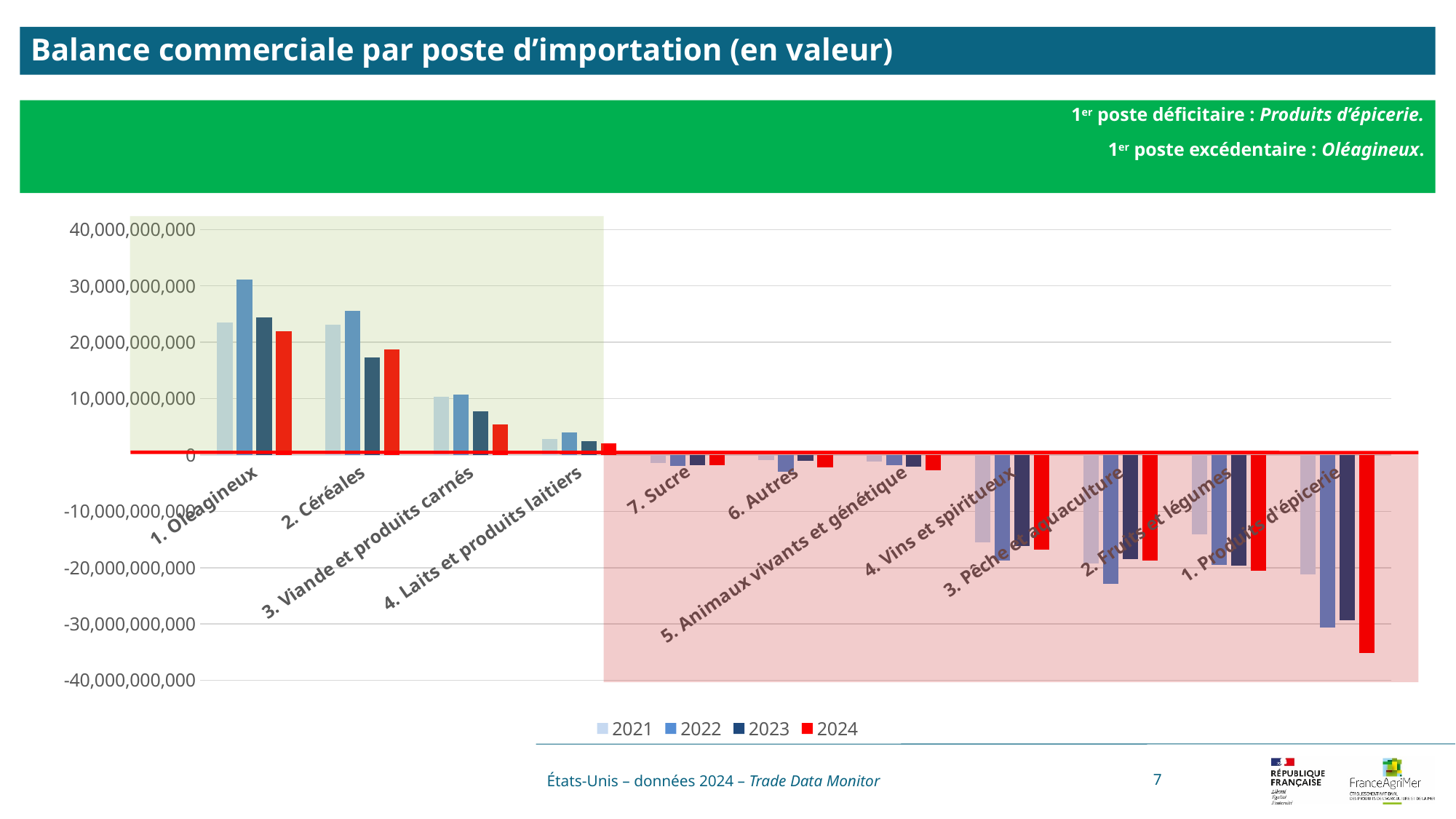
Is the 2024 value for 1. Produits d'épicerie greater or less than -30,000,000,000? less How many series does the legend list? 4 Is the 2022 value for 1. Oléagineux greater or less than 30,000,000,000? greater Which colour represents the 2024 series in the legend? red Which is larger in 2024: the value for 1. Oléagineux or the value for 2. Céréales? 1. Oléagineux How many import categories are shown on the x axis? 11 For 1. Produits d'épicerie, which year shows the largest deficit? 2024 Which category and year has the lowest value in the chart? 1. Produits d'épicerie, 2024 Is the 2024 value for 4. Vins et spiritueux greater or less than -10,000,000,000? less Which category and year has the highest value in the chart? 1. Oléagineux, 2022 What kind of chart is shown on the slide? bar chart